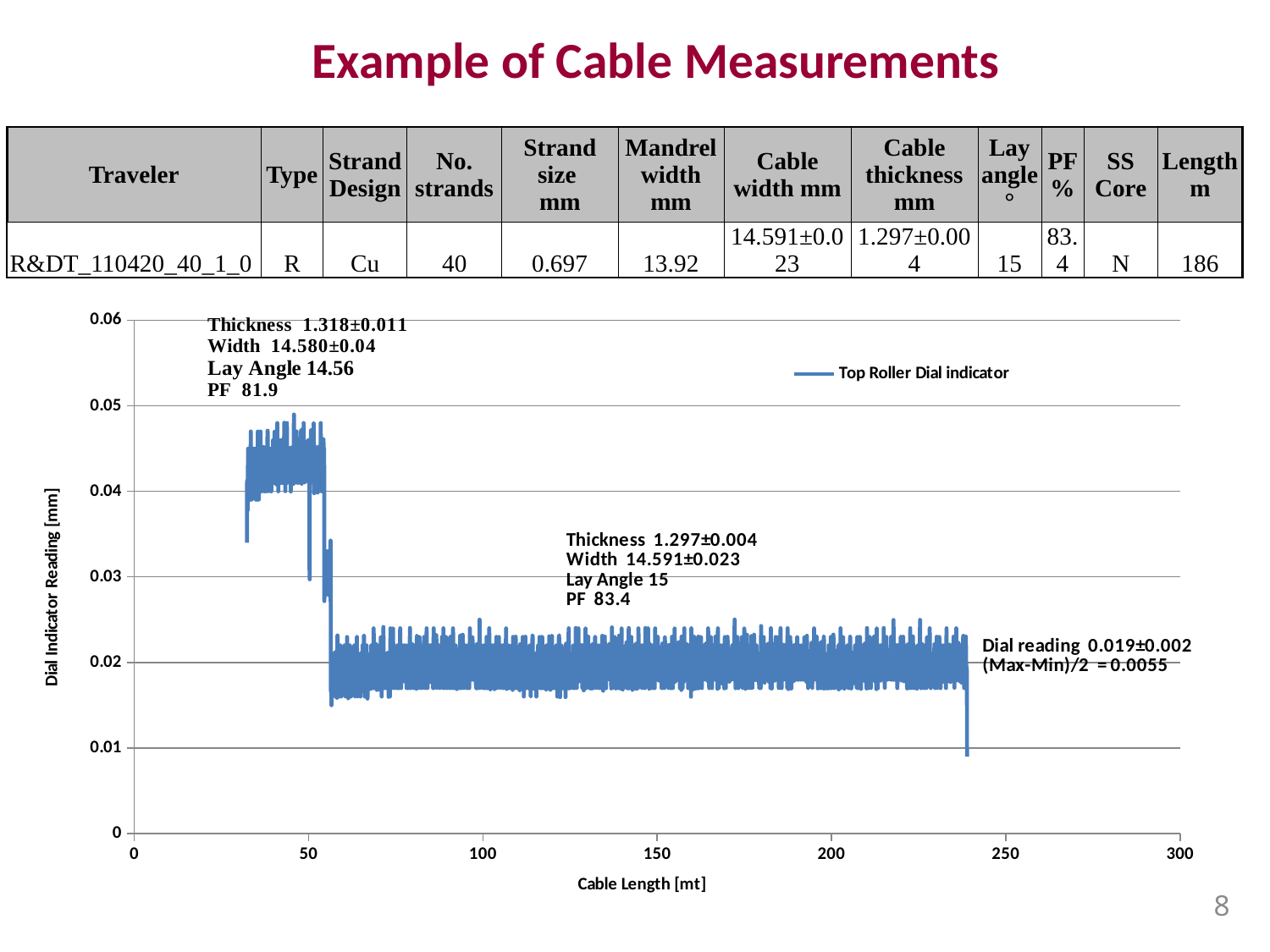
Is the dial indicator reading at a cable length of 40 mt greater or less than 0.03? greater According to the annotation on the chart, what is the value of (Max-Min)/2? 0.0055 What is the maximum value shown on the chart's y axis? 0.06 Is the dial indicator reading at a cable length of 200 mt greater or less than 0.04? less What kind of chart is shown on the slide? line chart How many series does the chart legend list? 1 Is the dial indicator reading at a cable length of 100 mt greater or less than 0.03? less Do the dial indicator readings rise or fall overall as cable length increases from 40 mt to 100 mt? fall Which is larger, the dial indicator reading at a cable length of 40 mt or at 150 mt? 40 mt According to the annotation on the chart, what is the dial reading for the long flat section? 0.019±0.002 What is the name of the series shown in the chart legend? Top Roller Dial indicator What is the title of the chart's x axis? Cable Length [mt]